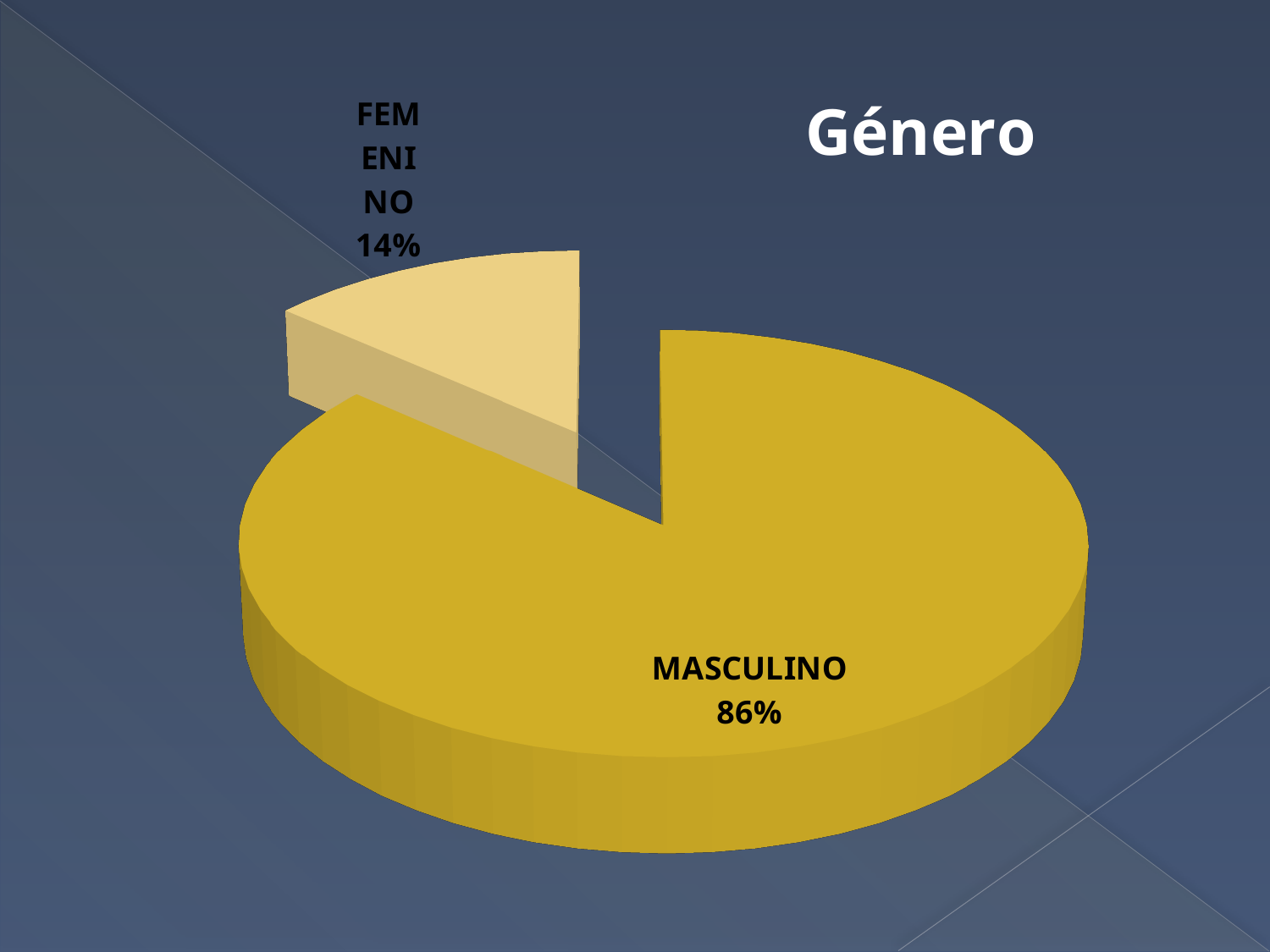
How many slices does the pie chart have? 2 What is the title of the chart? Género What is the difference in percentage points between MASCULINO and FEMENINO? 72 Which category has the smallest share of the pie? FEMENINO Which is larger, the share for MASCULINO or the share for FEMENINO? MASCULINO What percentage of the pie is MASCULINO? 86% What percentage of the pie is FEMENINO? 14% Which category has the largest share of the pie? MASCULINO Which slice is pulled out from the rest of the pie? FEMENINO What kind of chart is shown on the slide? pie chart